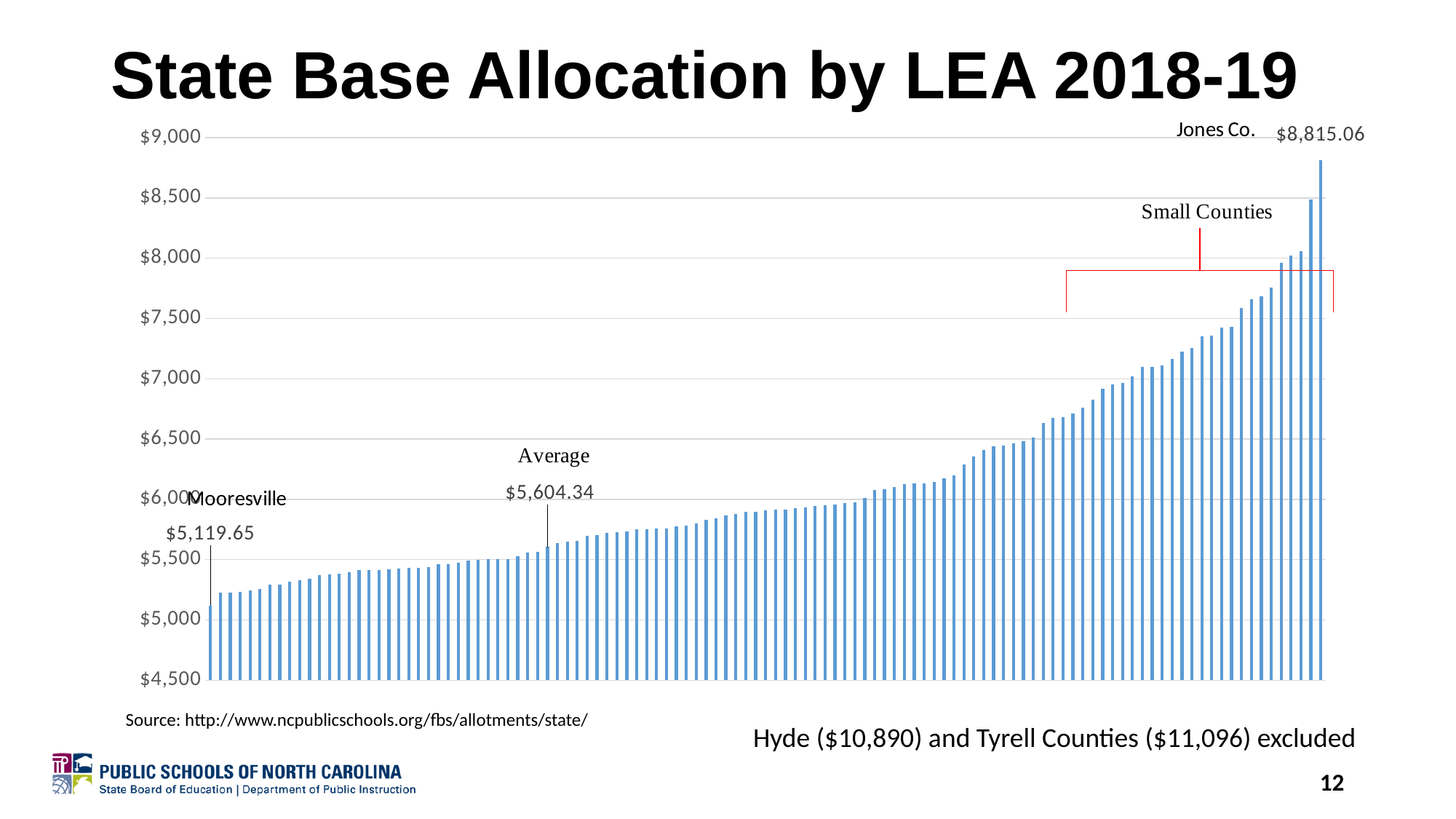
What is the difference between the allocation for Jones Co. and the allocation for Mooresville? $3,695.41 Do the bar values rise or fall from left to right along the x axis? Rise How much higher is the allocation for Jones Co. than the average of $5,604.34? $3,210.72 Which is larger, the allocation for Mooresville or the average allocation? Average Which two counties are excluded from the chart? Hyde and Tyrell Counties Which labeled LEA has the highest state base allocation on the chart? Jones Co. What is the state base allocation for Mooresville? $5,119.65 What is the average state base allocation shown on the chart? $5,604.34 Which labeled LEA has the lowest state base allocation on the chart? Mooresville Is the value for Mooresville greater or less than $5,500? less What kind of chart is shown on the slide? Bar chart What is the state base allocation for Jones Co.? $8,815.06